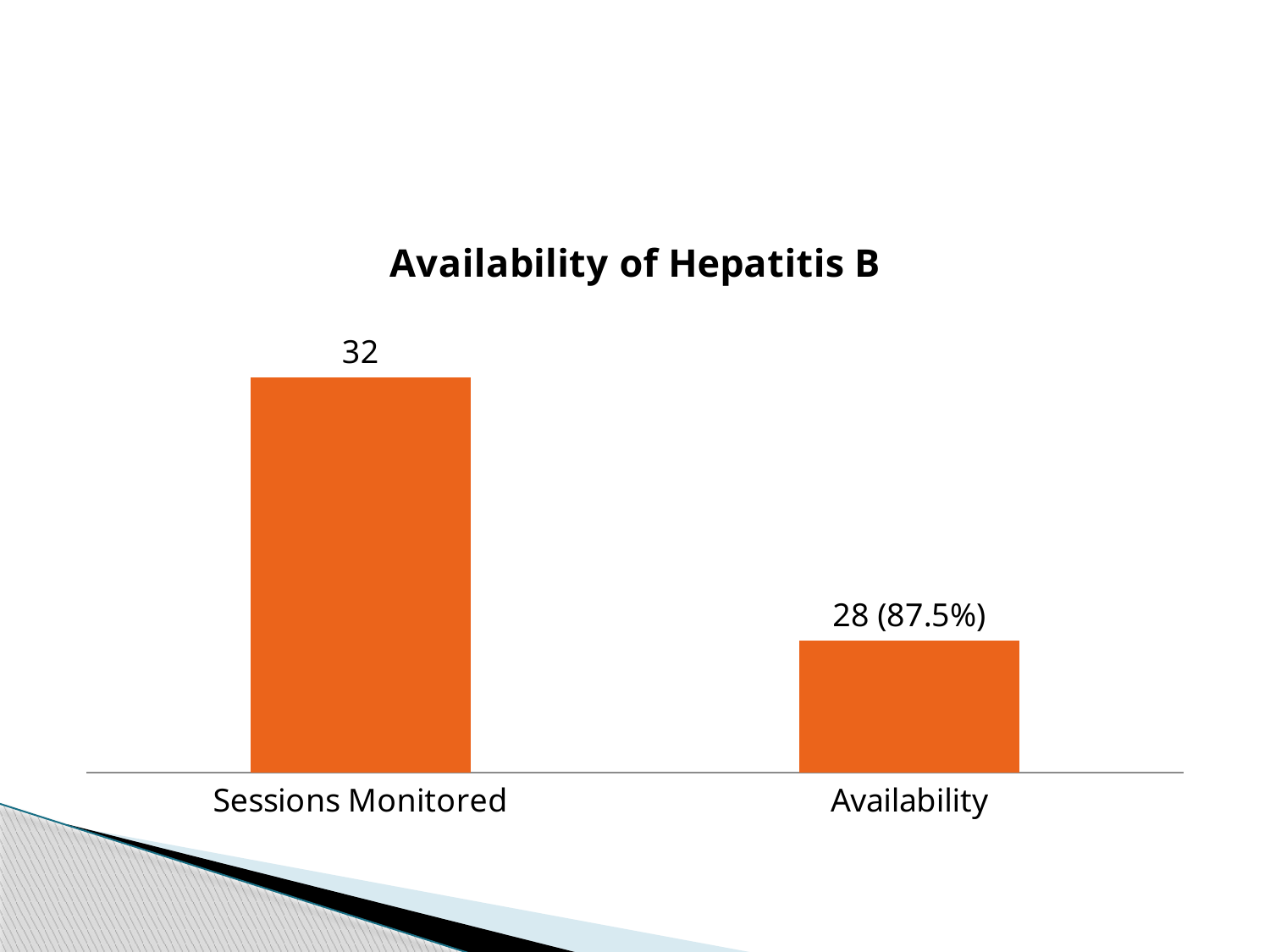
What percentage is shown in the label for Availability? 87.5% Which category has the lowest value? Availability What is the title of the chart? Availability of Hepatitis B Which category has the highest value? Sessions Monitored What is the difference between Sessions Monitored and Availability? 4 Do the values rise or fall from Sessions Monitored to Availability? Fall Which is larger, Sessions Monitored or Availability? Sessions Monitored What kind of chart is shown on the slide? Bar chart What is the data label shown on the Availability bar? 28 (87.5%) How many categories are shown in the chart? 2 What is the value for Sessions Monitored? 32 What colour are the bars in the chart? Orange